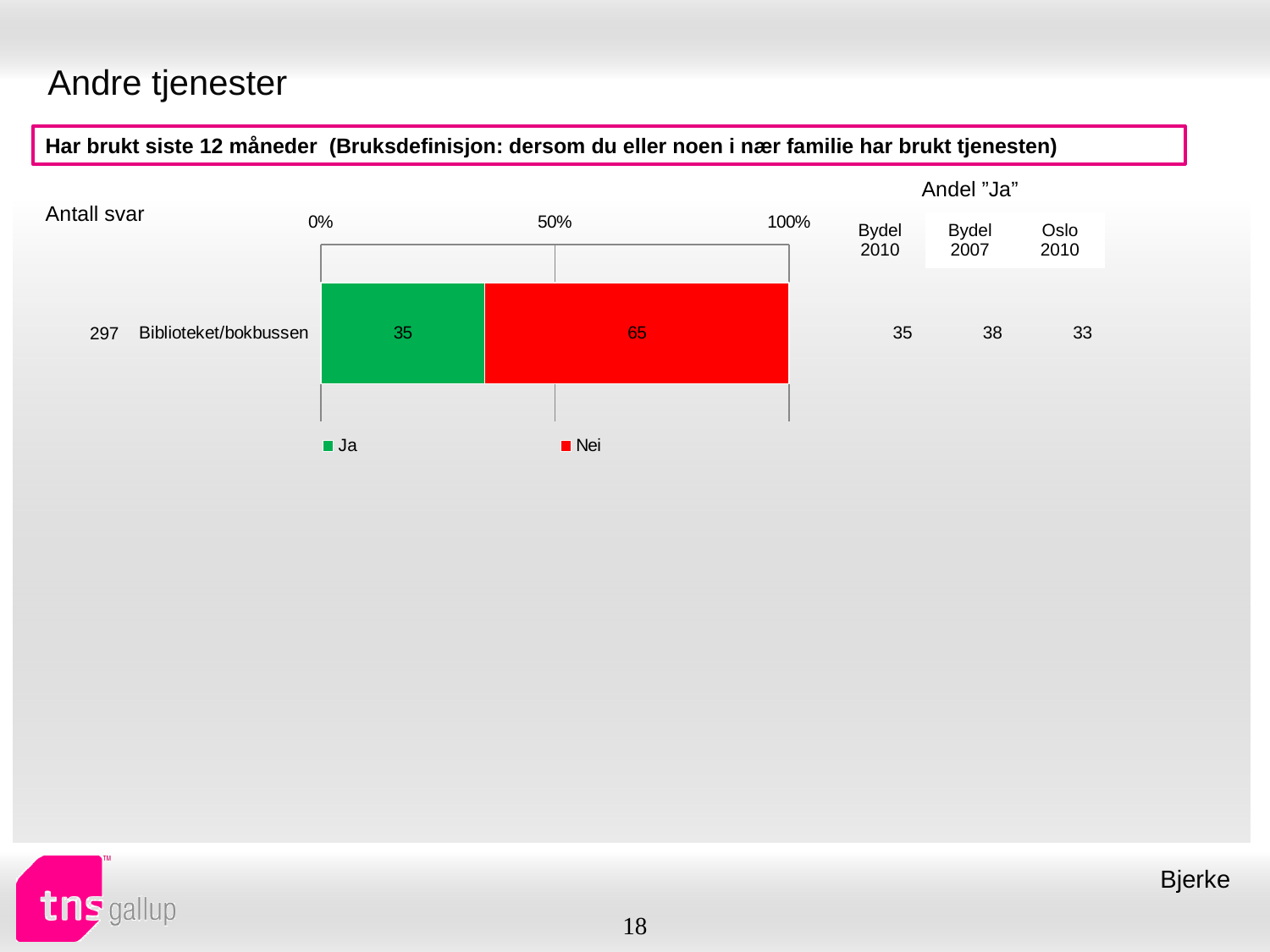
How many categories are plotted in the chart? 1 What kind of chart is shown on the slide? Stacked bar chart How many series does the legend list? 2 What is the value for "Nei" for Biblioteket/bokbussen? 65 What is the value for "Ja" for Biblioteket/bokbussen? 35 Which series has the larger value for Biblioteket/bokbussen, Ja or Nei? Nei Is the value for "Nei" for Biblioteket/bokbussen greater or less than 50%? greater Is the value for "Ja" for Biblioteket/bokbussen greater or less than 50%? less What is the difference between the Nei and Ja values for Biblioteket/bokbussen? 30 What colour represents "Ja" in the chart? Green What is the total of the stacked bar for Biblioteket/bokbussen? 100 What is the number of responses (Antall svar) for Biblioteket/bokbussen? 297